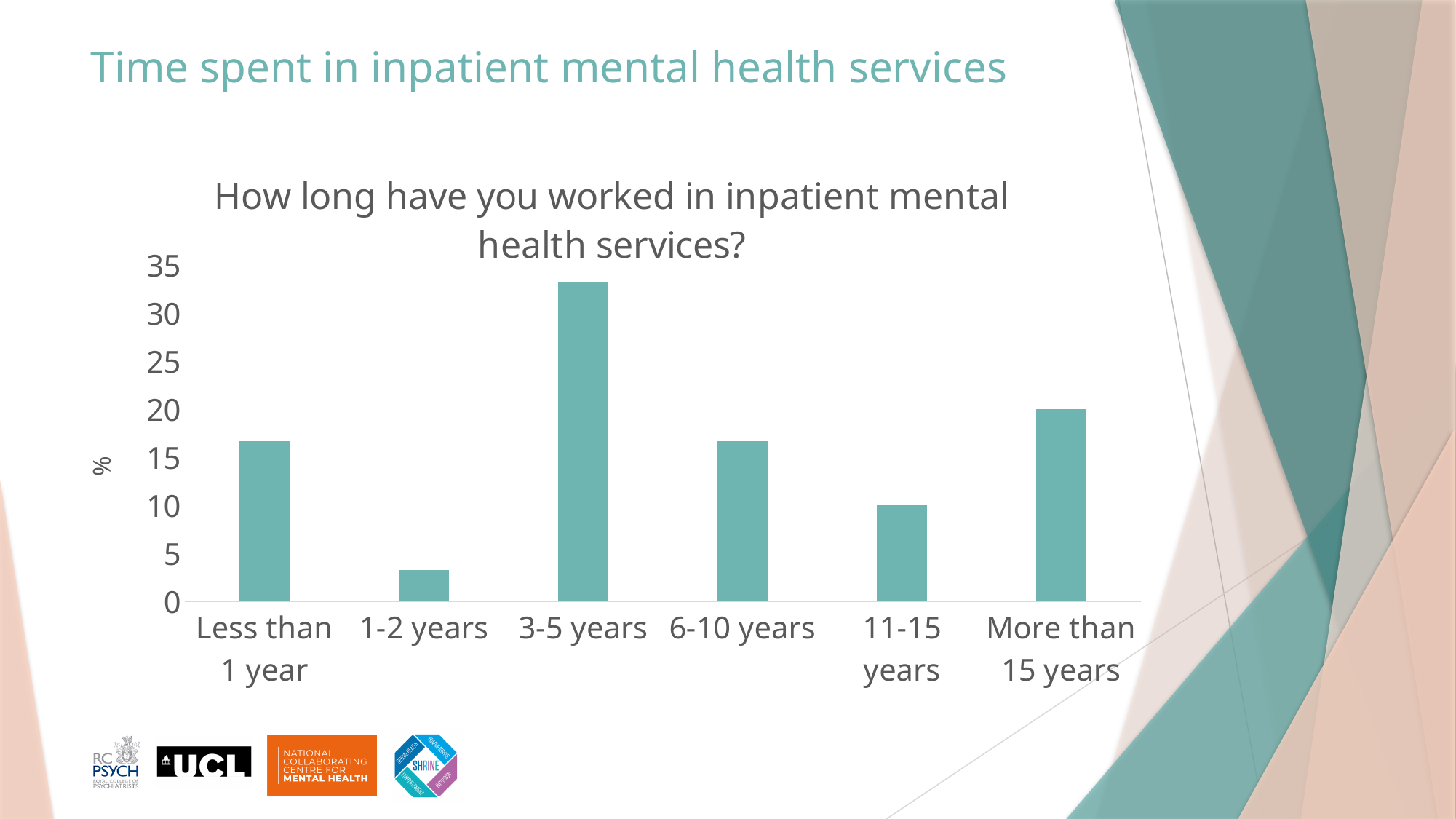
What is the title of the chart? How long have you worked in inpatient mental health services? Is the value for Less than 1 year greater or less than 15? greater How many categories are shown on the x axis of the chart? 6 Which is larger, the value for More than 15 years or the value for 11-15 years? More than 15 years Which is larger, the value for 3-5 years or the value for More than 15 years? 3-5 years What kind of chart is shown on the slide? bar chart Is the value for 6-10 years greater or less than 20? less Is the value for 3-5 years greater or less than 30? greater Which category has the highest value in the chart? 3-5 years Which category has the lowest value in the chart? 1-2 years What is the label on the y axis of the chart? %